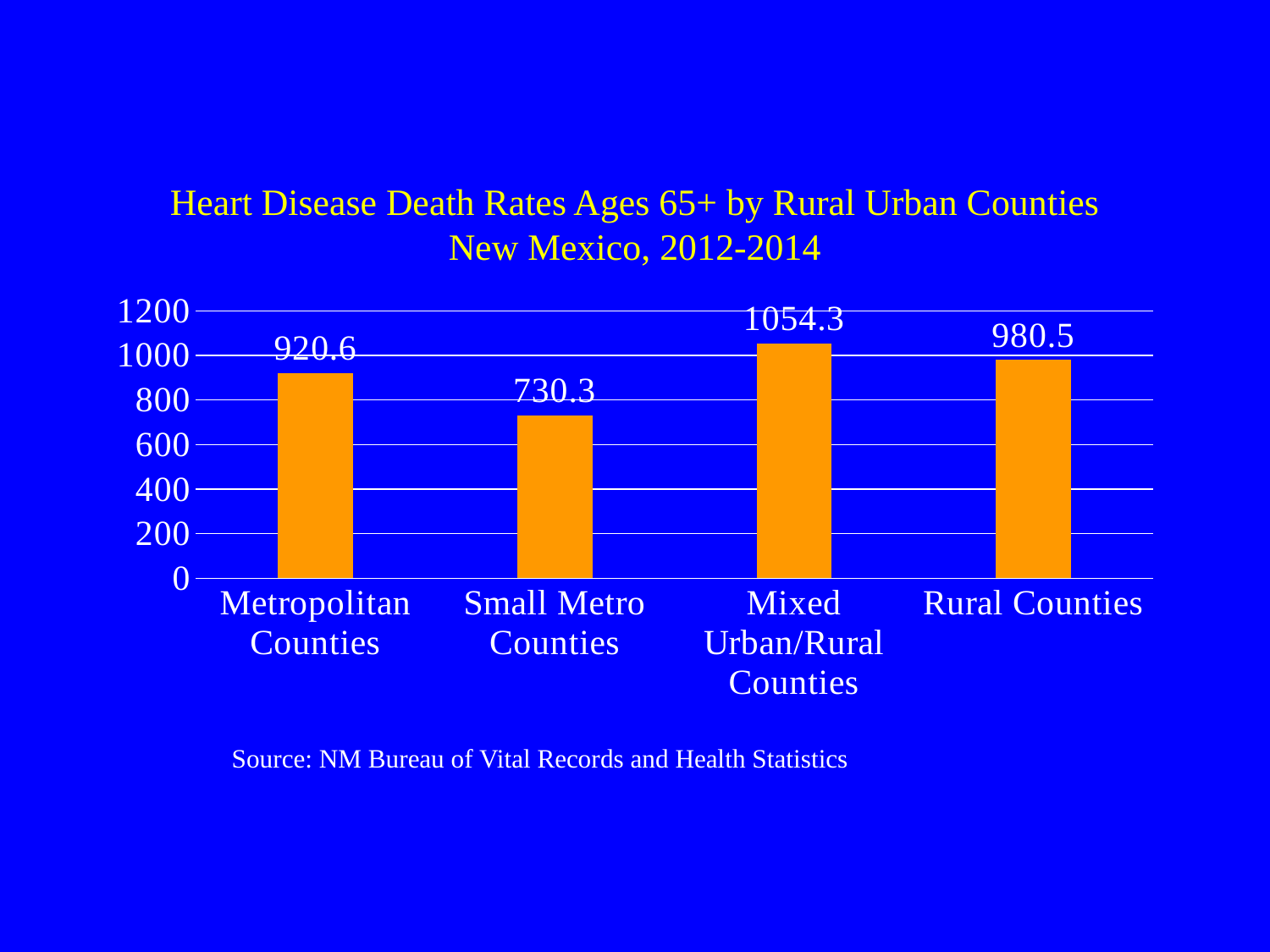
Which county type has the lowest heart disease death rate? Small Metro Counties Which has a higher heart disease death rate, Metropolitan Counties or Rural Counties? Rural Counties What is the difference between the death rates for Rural Counties and Metropolitan Counties? 59.9 What kind of chart is shown on the slide? Bar chart Is the value for Small Metro Counties greater or less than 800? less How many county categories are shown in the chart? 4 What is the heart disease death rate for Small Metro Counties? 730.3 What is the difference between the death rates for Mixed Urban/Rural Counties and Small Metro Counties? 324.0 What is the heart disease death rate for Mixed Urban/Rural Counties? 1054.3 What is the heart disease death rate for Rural Counties? 980.5 What is the heart disease death rate for Metropolitan Counties? 920.6 Which county type has the highest heart disease death rate? Mixed Urban/Rural Counties